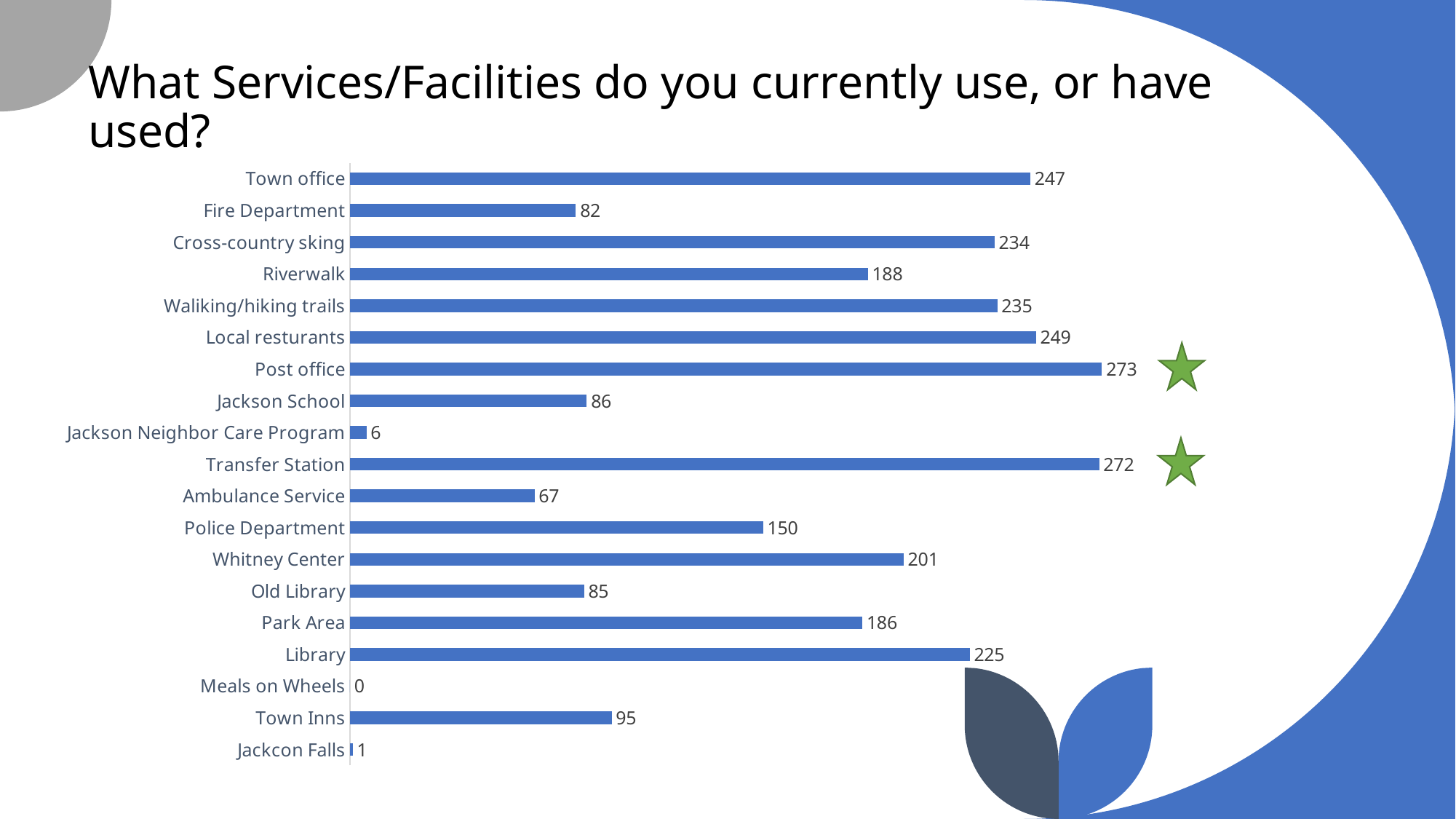
Which category has the highest value? Post office What value is shown for Jackson Neighbor Care Program? 6 Which is larger, the value for Riverwalk or the value for Park Area? Riverwalk What is the difference between the values for Local resturants and Fire Department? 167 Which is larger, the value for Police Department or the value for Whitney Center? Whitney Center What is the difference between the values for Library and Old Library? 140 What kind of chart is shown on the slide? Bar chart What value is shown for Transfer Station? 272 What value is shown for Town office? 247 How many categories are shown in the chart? 19 Which category has the lowest value? Meals on Wheels What is the title of the slide containing the chart? What Services/Facilities do you currently use, or have used?